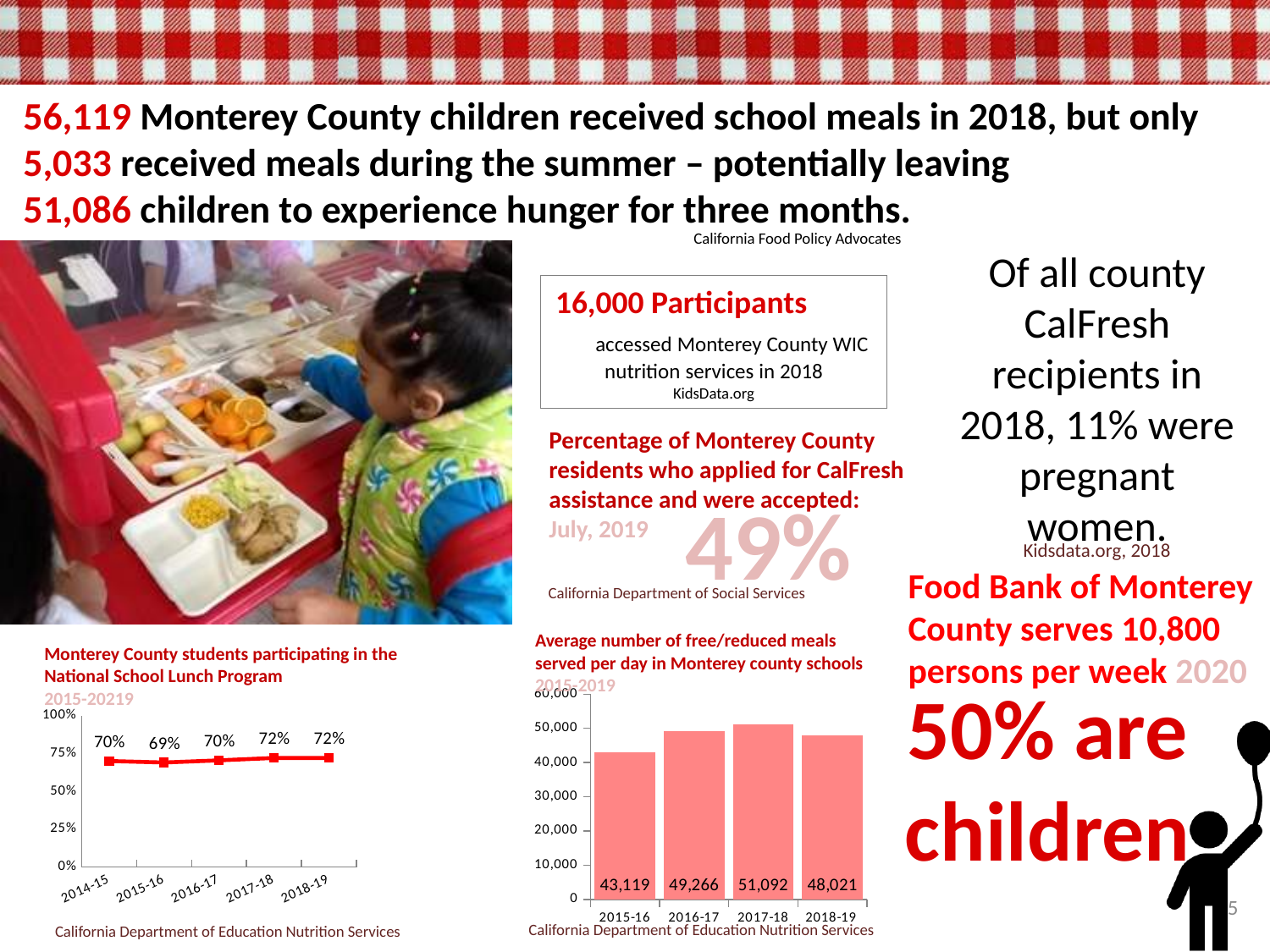
In the 'Monterey County students participating in the National School Lunch Program' chart, what is the value for 2018-19? 72% In the 'Monterey County students participating in the National School Lunch Program' chart, how many data points are plotted? 5 In the 'Average number of free/reduced meals served per day in Monterey county schools' chart, what is the difference between the 2017-18 and 2018-19 values? 3,071 In the 'Average number of free/reduced meals served per day in Monterey county schools' chart, what is the value for 2015-16? 43,119 In the 'Average number of free/reduced meals served per day in Monterey county schools' chart, how many school years are shown? 4 In the 'Monterey County students participating in the National School Lunch Program' chart, what is the value for 2015-16? 69% In the 'Average number of free/reduced meals served per day in Monterey county schools' chart, which school year has the lowest value? 2015-16 What kind of chart is 'Monterey County students participating in the National School Lunch Program'? line chart What kind of chart is 'Average number of free/reduced meals served per day in Monterey county schools'? bar chart In the 'Average number of free/reduced meals served per day in Monterey county schools' chart, which school year has the highest value? 2017-18 In the 'Average number of free/reduced meals served per day in Monterey county schools' chart, what is the value for 2017-18? 51,092 In the 'Monterey County students participating in the National School Lunch Program' chart, which year has the lowest value? 2015-16